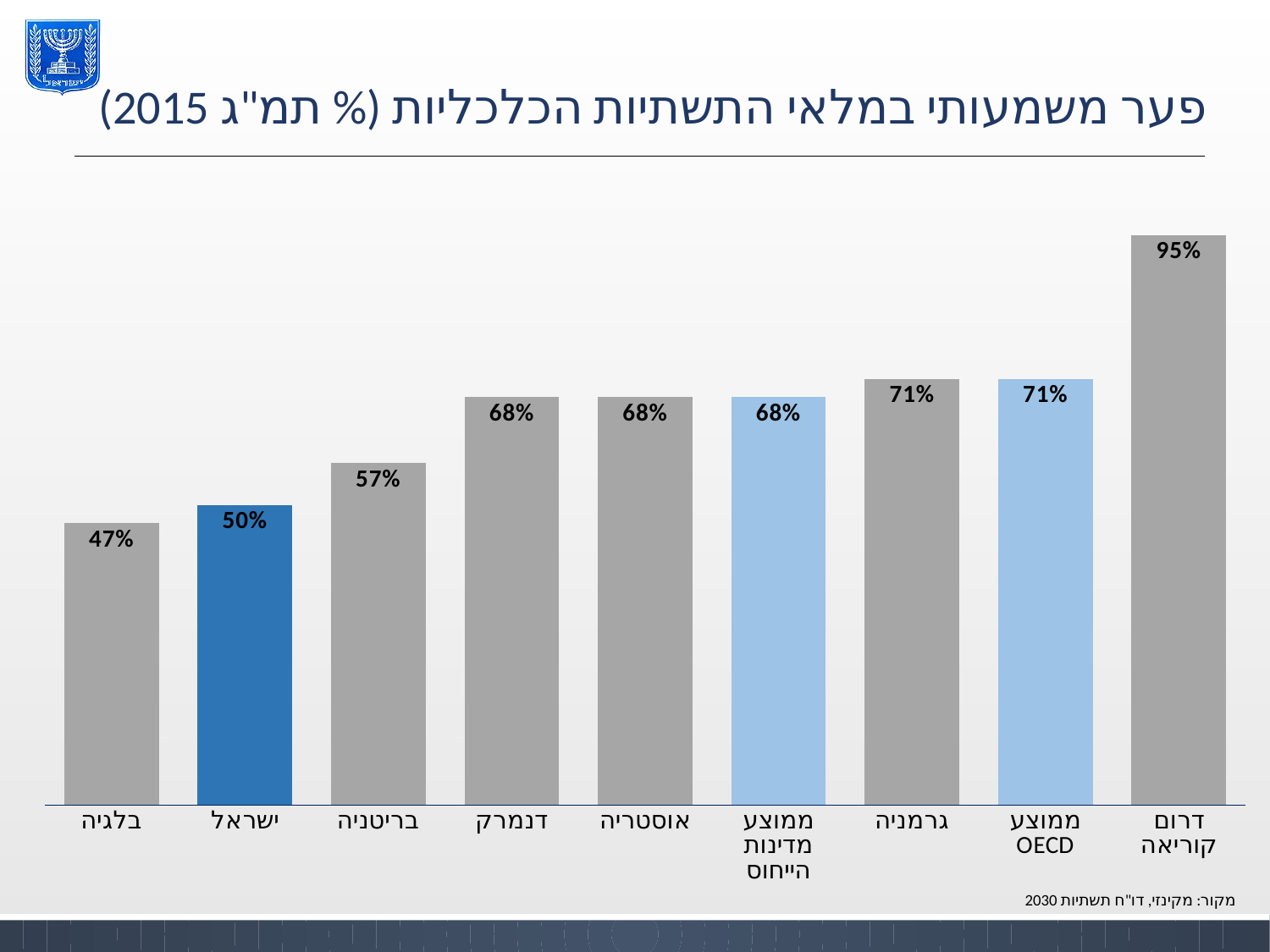
What is the value for בלגיה (Belgium)? 47% What kind of chart is shown on the slide? Bar chart What is the value for דרום קוריאה (South Korea)? 95% Which bar is drawn in dark blue, unlike the grey bars? ישראל (Israel) Which category has the highest value? דרום קוריאה (South Korea) What is the difference between the value for ממוצע OECD (OECD average) and the value for ישראל (Israel)? 21% What is the value for ישראל (Israel)? 50% What is the difference between the value for דרום קוריאה (South Korea) and the value for ישראל (Israel)? 45% What is the value for ממוצע OECD (OECD average)? 71% Which category has the lowest value? בלגיה (Belgium) How many bars are shown in the chart? 9 Which is larger, the value for בריטניה (Britain) or the value for גרמניה (Germany)? גרמניה (Germany)